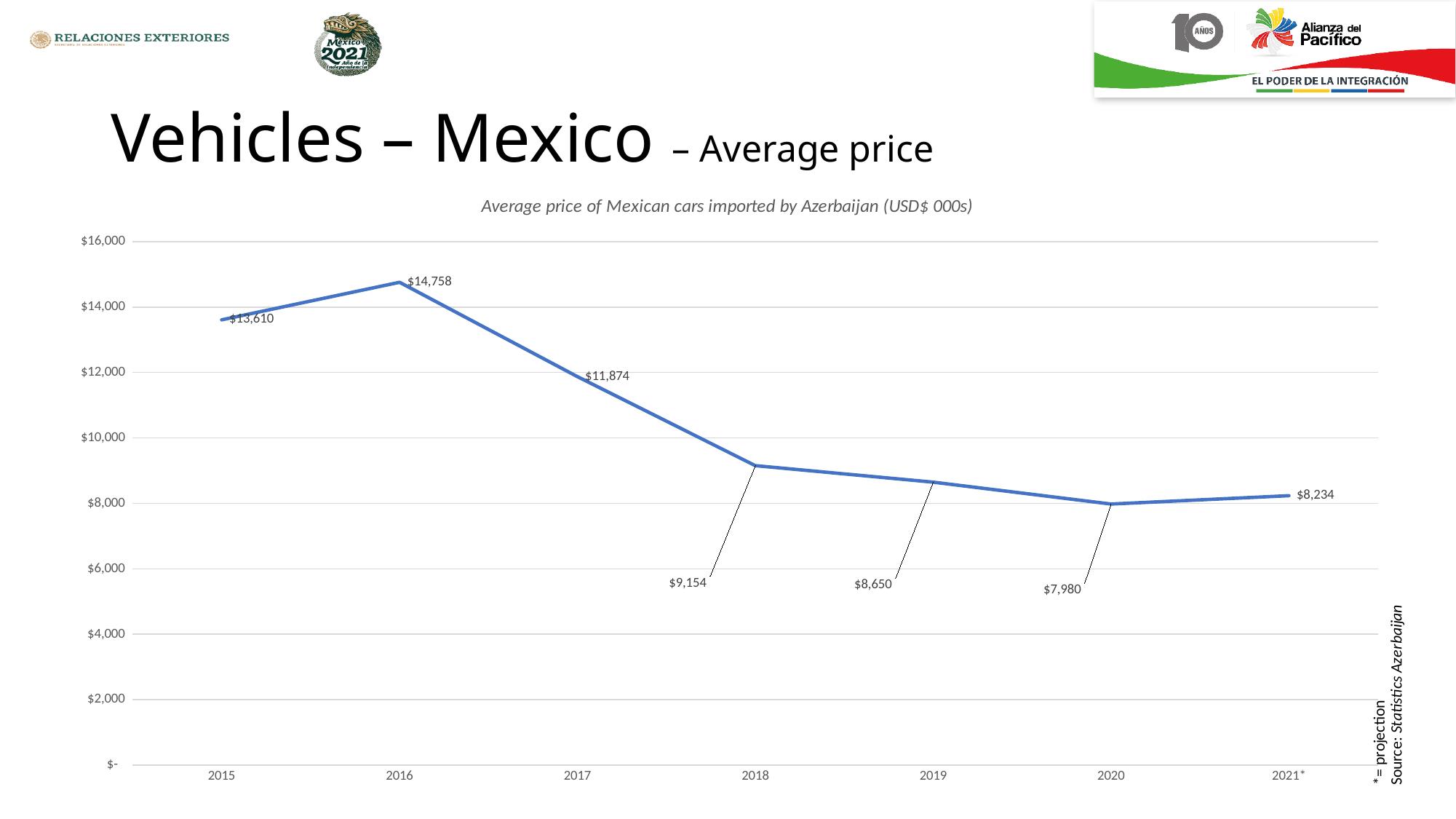
What kind of chart is shown on the slide? line chart Is the average price in 2017 greater or less than $12,000? less Which year has the lowest average price? 2020 How many years are plotted on the chart? 7 What is the source cited for the chart? Statistics Azerbaijan What is the projected average price for 2021*? $8,234 Which year has the highest average price? 2016 What was the average price of Mexican cars imported by Azerbaijan in 2016? $14,758 Which year had a higher average price, 2015 or 2019? 2015 Does the average price rise or fall between 2016 and 2020? fall What is the difference between the average price in 2016 and in 2017? $2,884 What was the average price of Mexican cars imported by Azerbaijan in 2018? $9,154